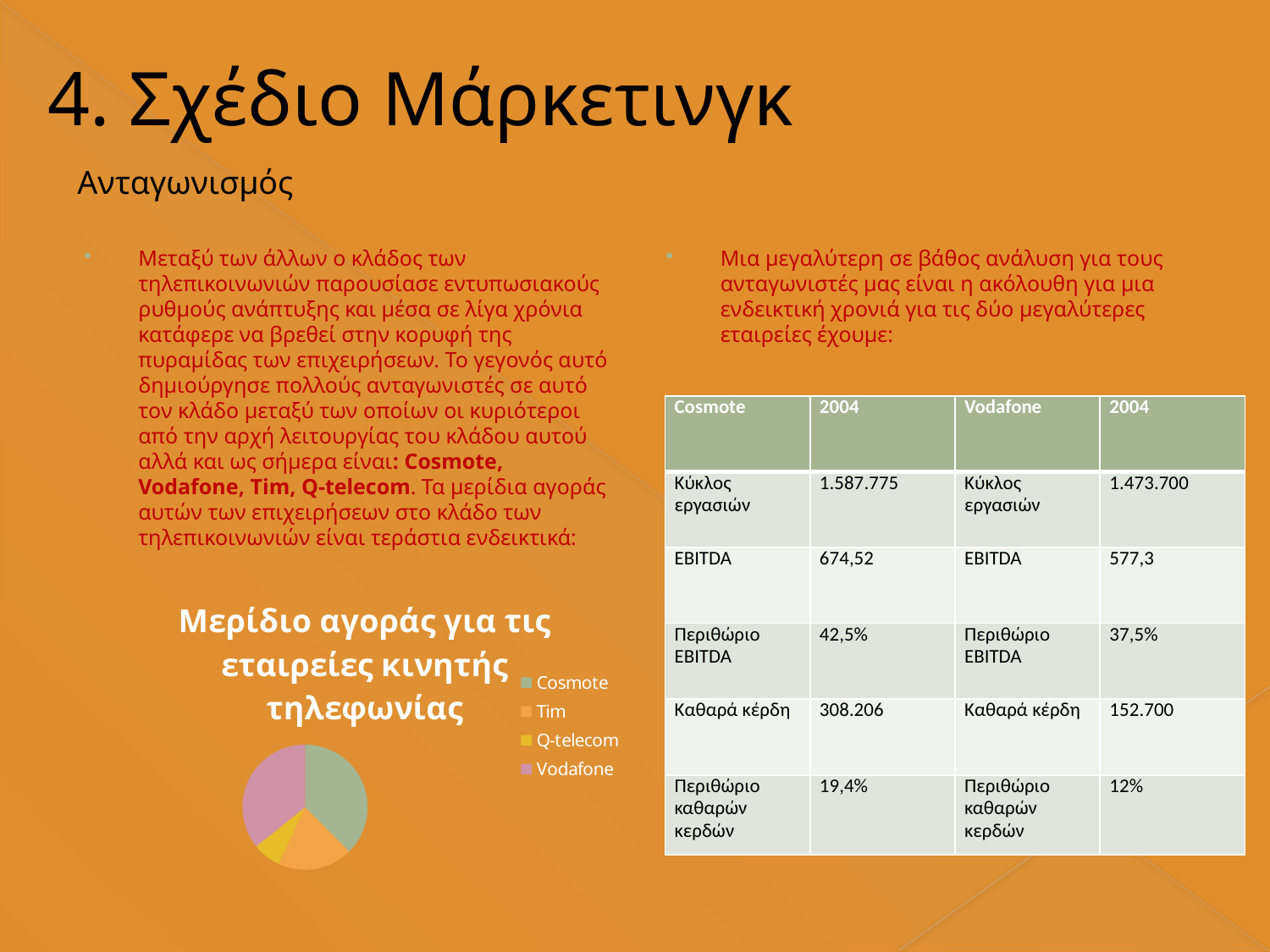
Which company is represented by the yellow slice in the pie chart? Q-telecom How many companies (slices) does the pie chart show? 4 Which slice is larger in the pie chart, Cosmote or Tim? Cosmote What kind of chart is shown on the slide? Pie chart Which company has the largest slice in the pie chart? Cosmote Which slice is larger in the pie chart, Cosmote or Q-telecom? Cosmote How many entries does the legend of the pie chart list? 4 Which slice is larger in the pie chart, Vodafone or Q-telecom? Vodafone Which company has the smallest slice in the pie chart? Q-telecom What is the title of the pie chart? Μερίδιο αγοράς για τις εταιρείες κινητής τηλεφωνίας